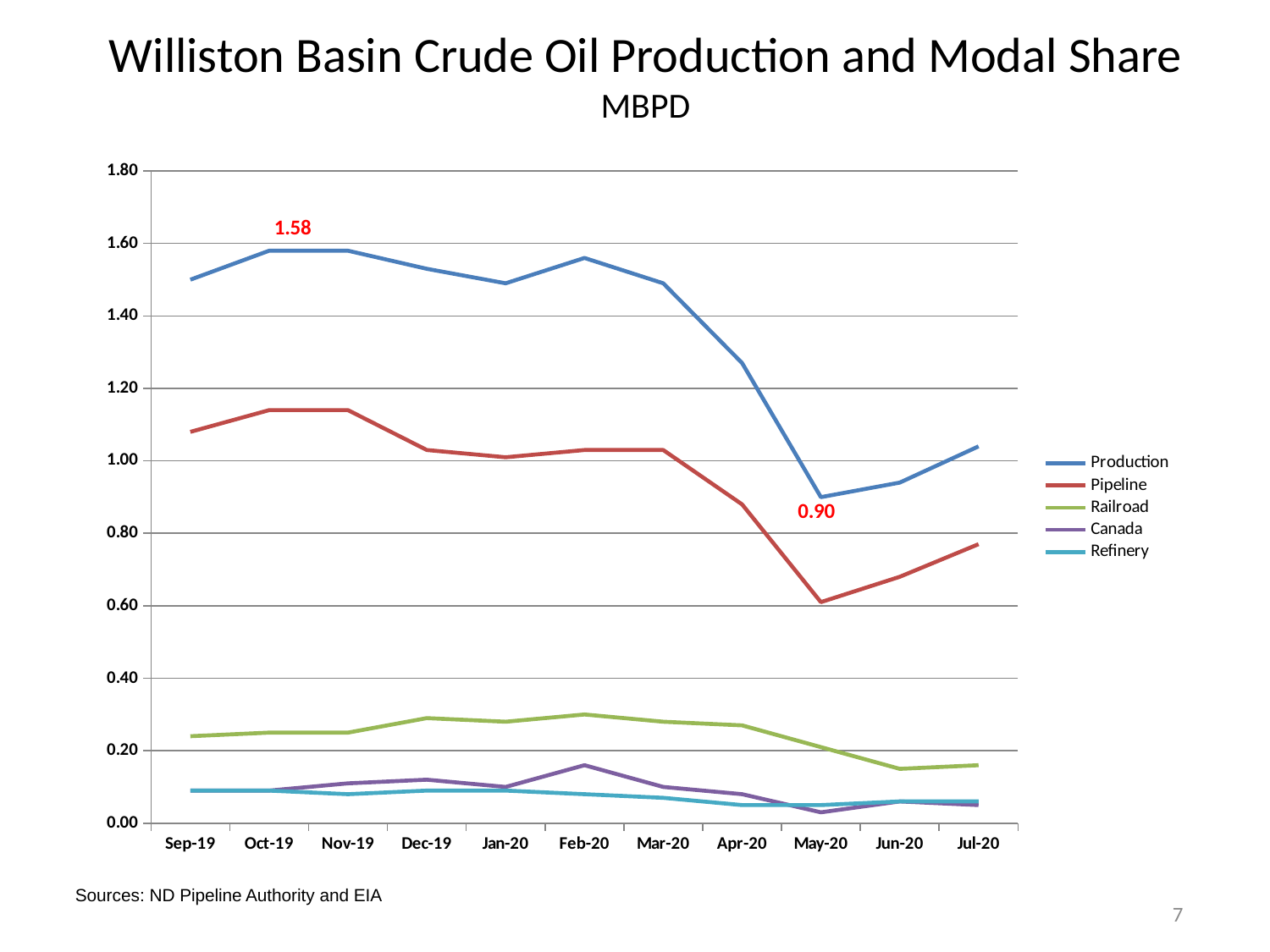
How many months are shown on the x axis? 11 In which month is the Pipeline series at its lowest? May-20 What is the difference between the Production values for Oct-19 and May-20? 0.68 Is the Railroad value for Jun-20 greater or less than 0.20? less Is the Pipeline value for Sep-19 greater or less than 1.00? greater How many series does the legend list? 5 What kind of chart is shown on the slide? Line chart What is the Production value for May-20? 0.90 What is the Production value for Oct-19? 1.58 Which series has the larger value in Sep-19, Pipeline or Railroad? Pipeline Does the Production series rise or fall from Mar-20 to May-20? Fall In which month is the Production series at its lowest? May-20